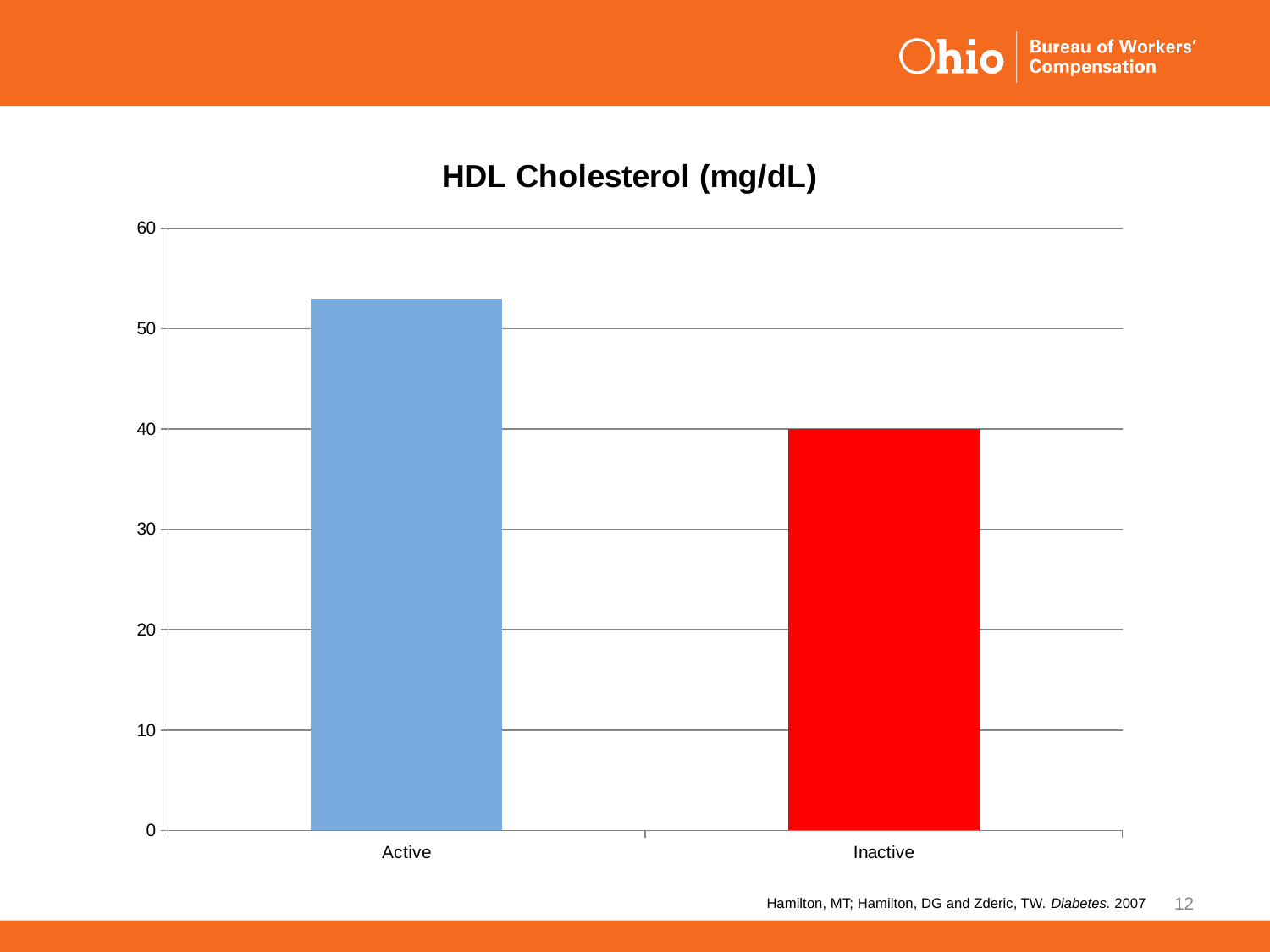
What is the maximum value shown on the y axis? 60 What kind of chart is shown on the slide? bar chart What is the title of the chart? HDL Cholesterol (mg/dL) Which category has the lowest HDL cholesterol value? Inactive What colour is the bar for Inactive? red Which is larger, the value for Active or the value for Inactive? Active Is the value for Active greater or less than 50? greater Is the value for Inactive greater or less than 50? less What is the HDL cholesterol value for Inactive? 40 Which category has the highest HDL cholesterol value? Active How many categories are shown on the x axis? 2